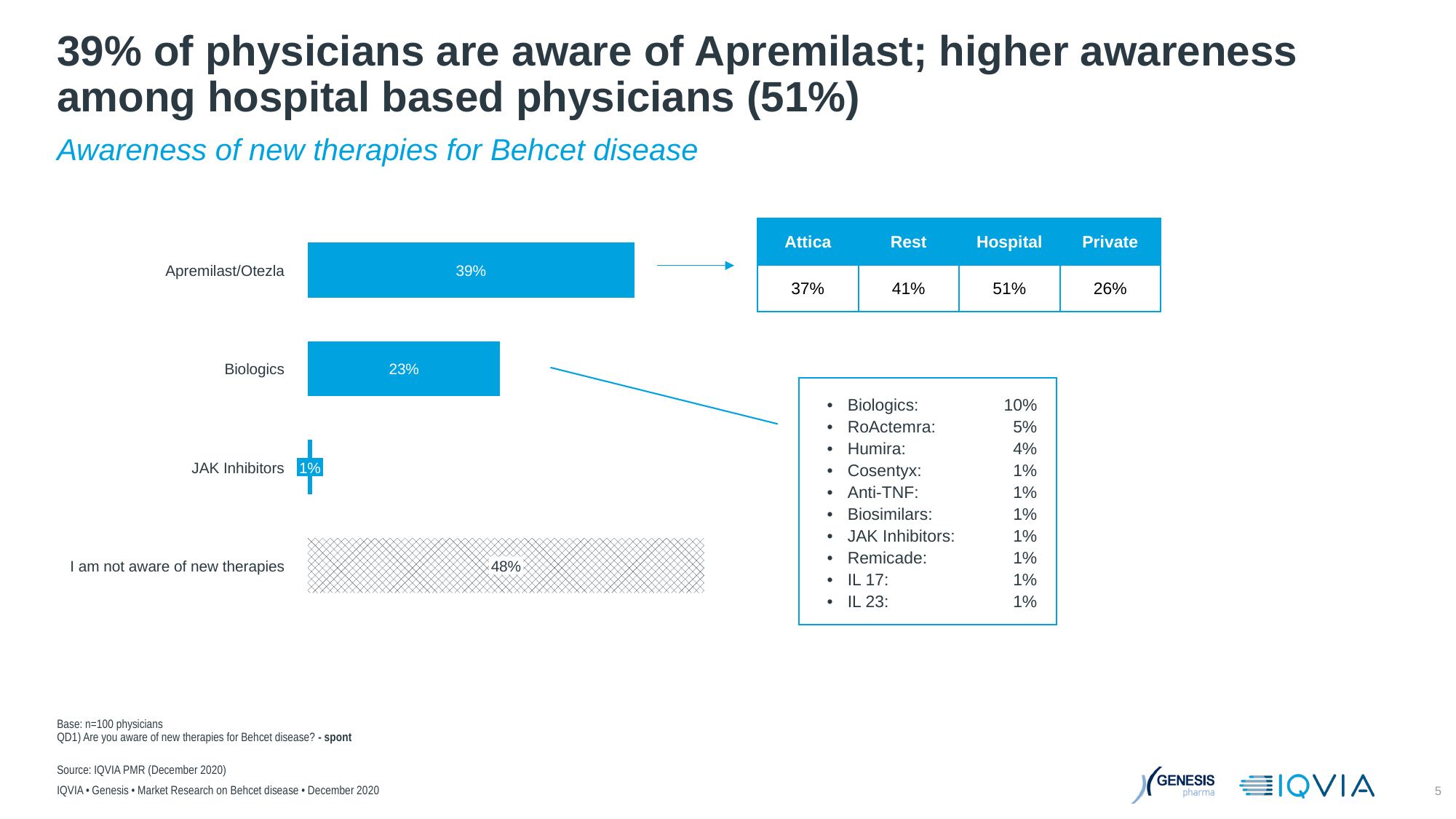
Which category in the bar chart has the lowest value? JAK Inhibitors What percentage of physicians are aware of Apremilast/Otezla? 39% What type of chart is shown on the slide? Bar chart In the table next to the Apremilast/Otezla bar, what is the awareness among hospital physicians? 51% In the table next to the Apremilast/Otezla bar, what is the difference between Hospital and Private awareness? 25 percentage points Which category in the bar chart has the highest value? I am not aware of new therapies What percentage of physicians are aware of Biologics? 23% What percentage of physicians said they are not aware of new therapies? 48% What is the difference between the awareness of Apremilast/Otezla and Biologics? 16 percentage points Which is larger: awareness of Apremilast/Otezla or the share not aware of new therapies? I am not aware of new therapies What percentage of physicians are aware of JAK Inhibitors? 1% How many categories are shown in the bar chart? 4